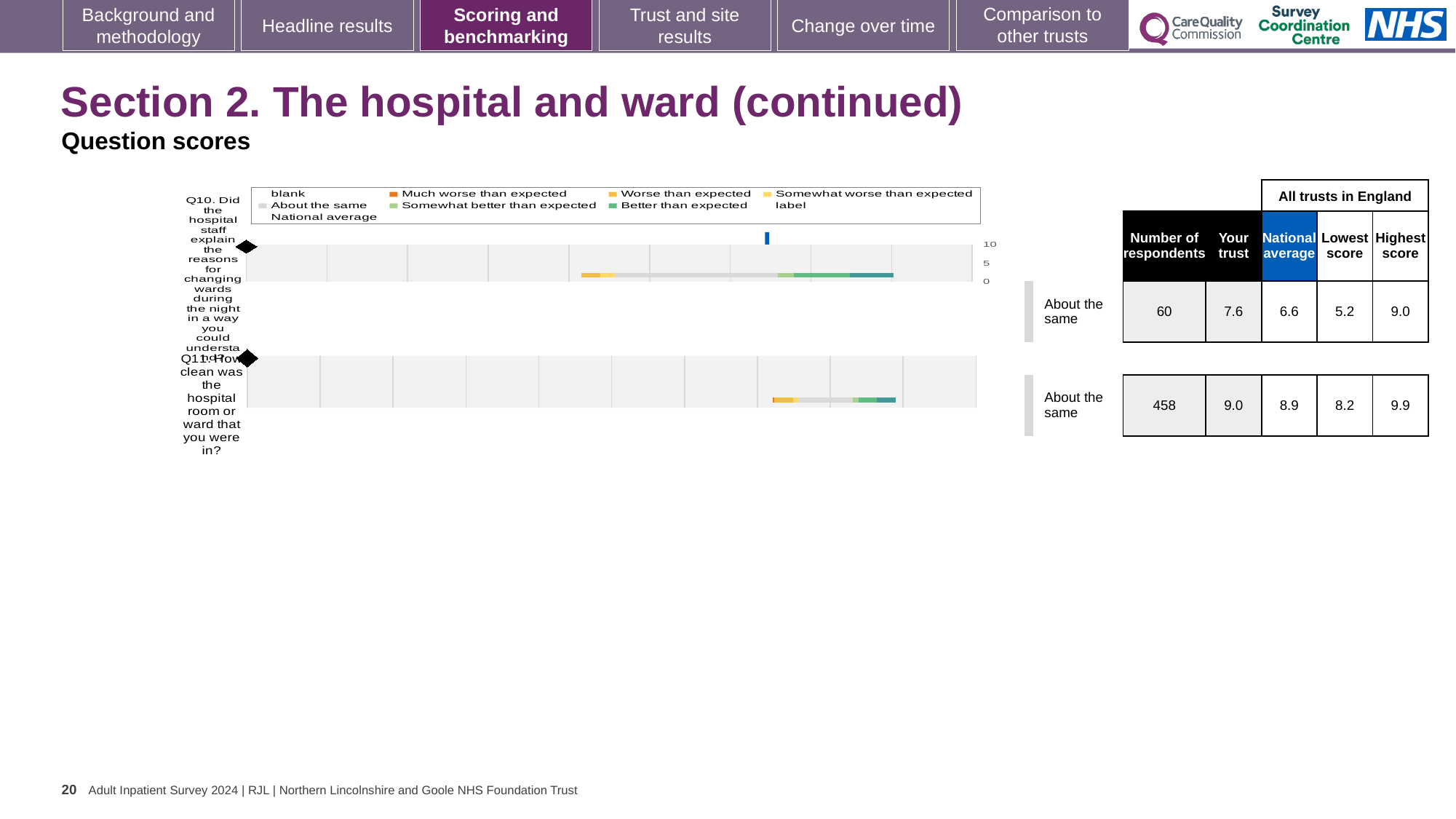
Which question has the higher 'Your trust' score, Q10 or Q11? Q11 Is the trust's score for Q10 greater or less than 5? greater How many survey questions are plotted on the slide? 2 How many respondents answered Q11? 458 What kind of chart is used to show the question scores for Q10 and Q11? bar chart What benchmark category is shown for Q11? About the same What is the 'Your trust' score for Q11 (how clean was the hospital room or ward)? 9.0 What is the difference between the highest score and the lowest score for Q11? 1.7 What is the national average score for Q10? 6.6 What is the 'Your trust' score for Q10 (explaining reasons for changing wards during the night)? 7.6 By how much does the trust's score for Q10 exceed the national average? 1.0 What is the highest tick value shown on the score axis of the Q10 chart? 10